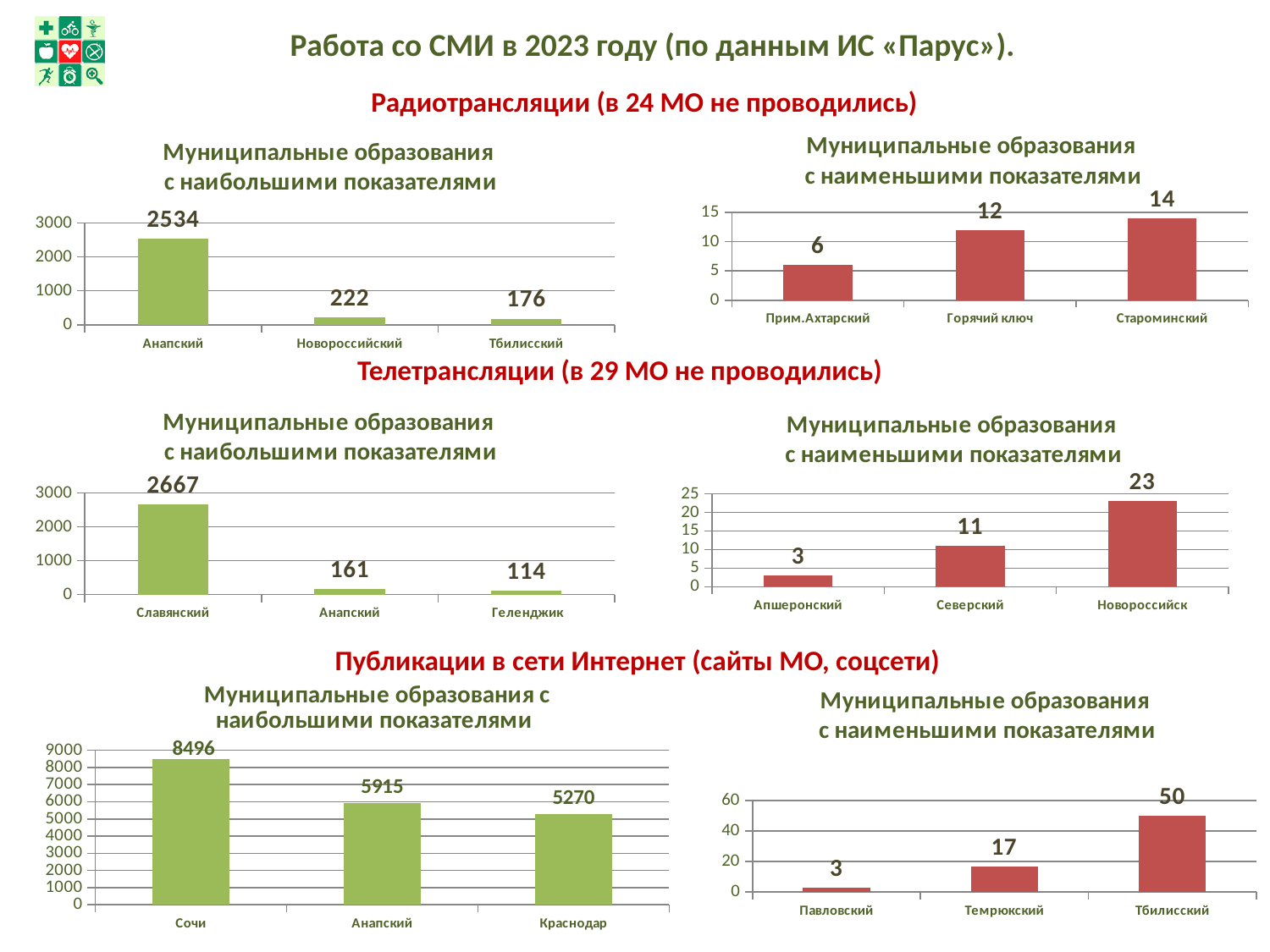
In the internet publications chart of municipalities with the highest figures (bottom left), how many municipalities are shown? 3 In the TV broadcasts chart of municipalities with the highest figures (middle left), which municipality has the highest value? Славянский What type of chart is used for the radio broadcasts chart of municipalities with the highest figures (top left)? bar chart In the radio broadcasts chart of municipalities with the lowest figures (top right), what is the difference between Староминский and Горячий ключ? 2 In the TV broadcasts chart of municipalities with the lowest figures (middle right), which is larger: Апшеронский or Северский? Северский In the internet publications chart of municipalities with the lowest figures (bottom right), do the values rise or fall from left to right? rise In the internet publications chart of municipalities with the highest figures (bottom left), what is the difference between Сочи and Краснодар? 3226 In the radio broadcasts chart of municipalities with the lowest figures (top right), which municipality has the lowest value? Прим.Ахтарский In the radio broadcasts chart of municipalities with the highest figures (top left), what is the value for Анапский? 2534 In the TV broadcasts chart of municipalities with the highest figures (middle left), what is the value for Геленджик? 114 In the internet publications chart of municipalities with the lowest figures (bottom right), what is the value for Темрюкский? 17 In the TV broadcasts chart of municipalities with the lowest figures (middle right), what is the value for Новороссийск? 23